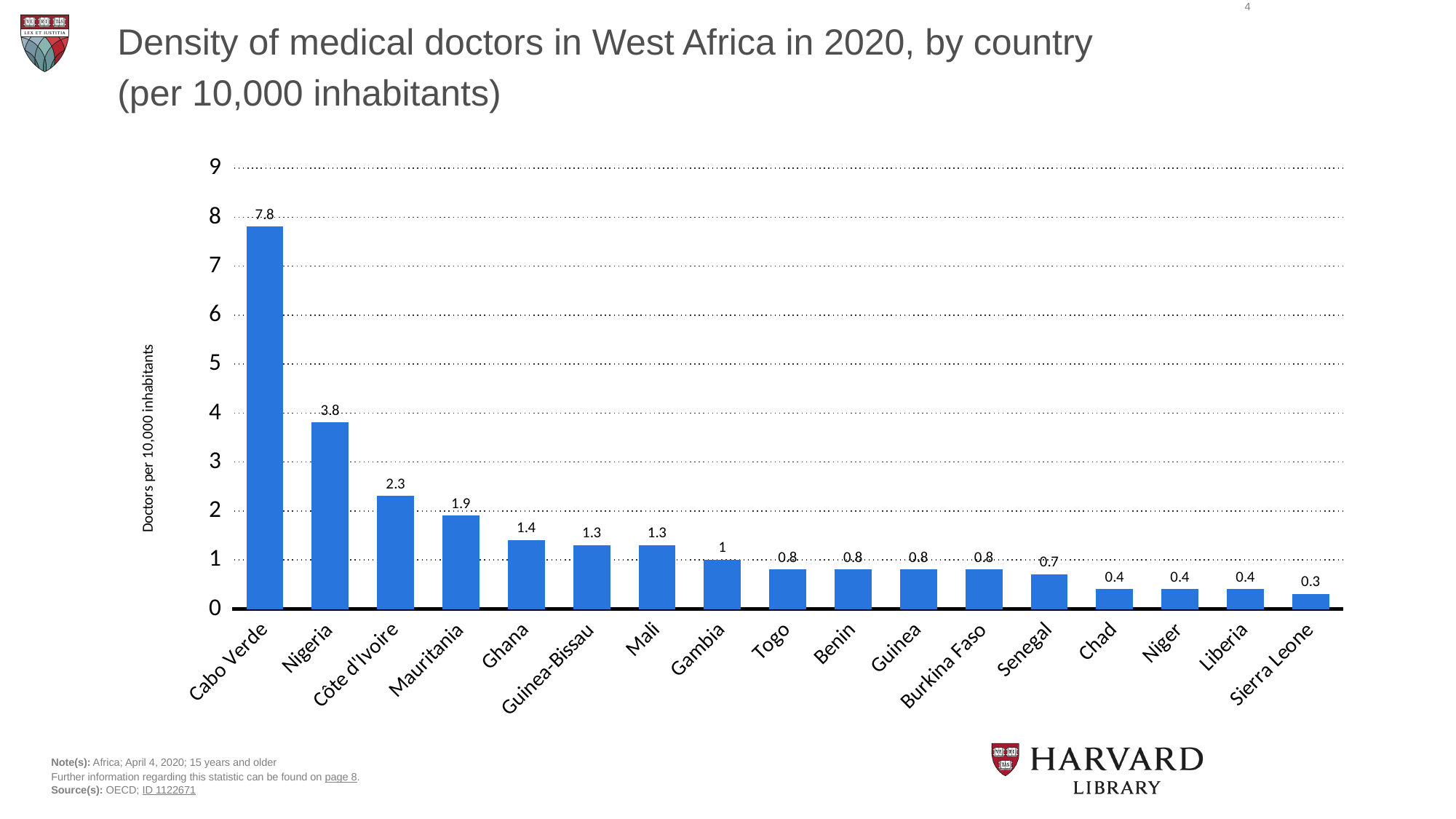
Which country has the highest density of medical doctors? Cabo Verde Which country has the lowest density of medical doctors? Sierra Leone What is the difference between the values for Cabo Verde and Nigeria? 4 What is the value shown for Senegal? 0.7 What is the label of the vertical axis? Doctors per 10,000 inhabitants What is the difference between the values for Côte d'Ivoire and Ghana? 0.9 Which has a higher value, Mauritania or Gambia? Mauritania What kind of chart is shown on the slide? Bar chart How many countries are shown in the chart? 17 What is the value shown for Mauritania? 1.9 What is the value shown for Nigeria? 3.8 What is the density of medical doctors in Cabo Verde? 7.8